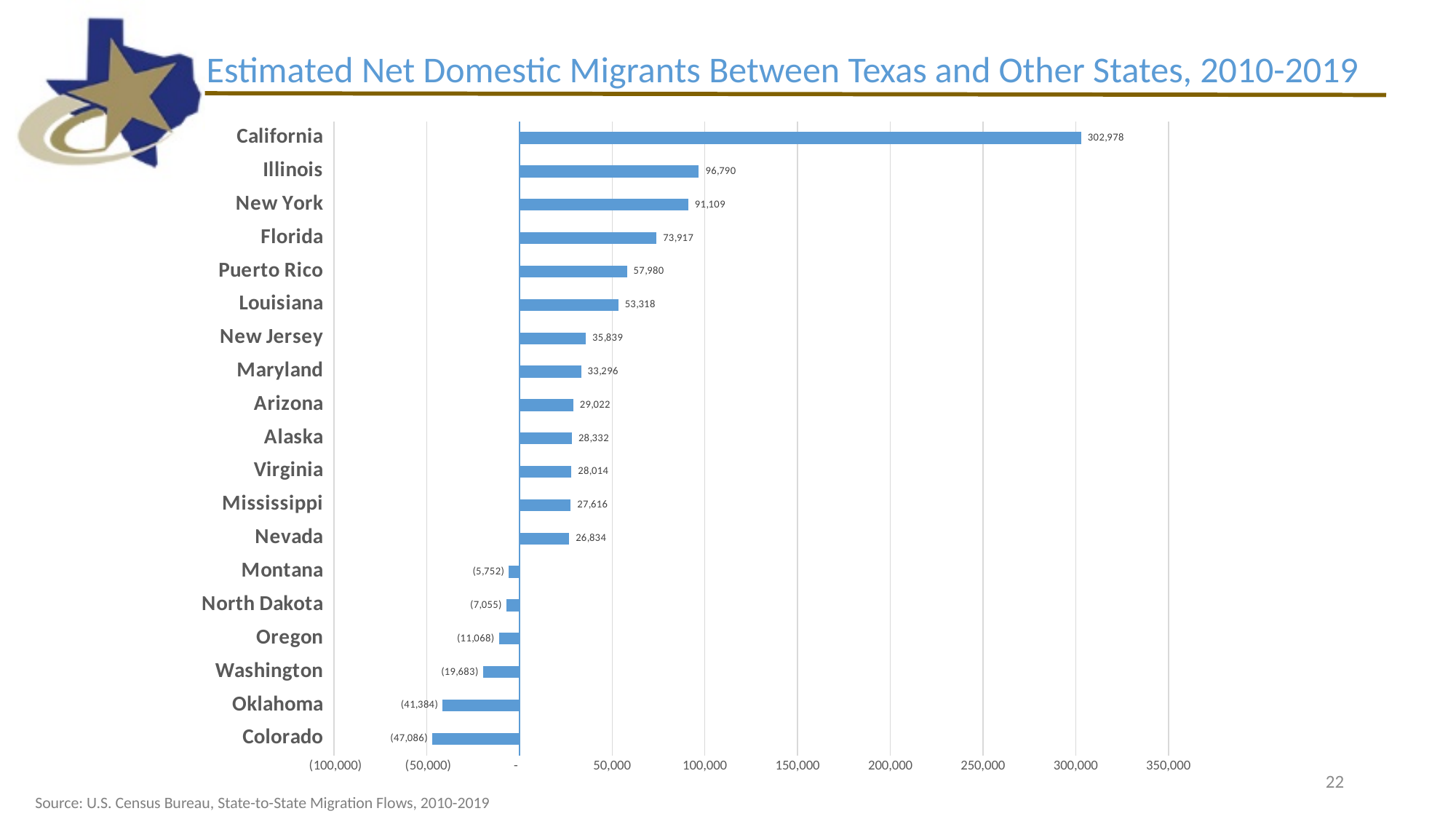
What is the difference between the values for Illinois and New York? 5,681 Which has a larger value, Florida or Louisiana? Florida How many categories on the chart have negative values? 6 What is the value shown for Colorado? (47,086) What is the estimated net domestic migration value for California? 302,978 What is the title of the chart? Estimated Net Domestic Migrants Between Texas and Other States, 2010-2019 What kind of chart is shown on the slide? Bar chart Which state has the lowest (most negative) value on the chart? Colorado Is the value for New Jersey greater or less than 50,000? less How many states or territories are shown on the chart? 19 Which state has the highest net domestic migration to Texas? California What is the value shown for Puerto Rico? 57,980